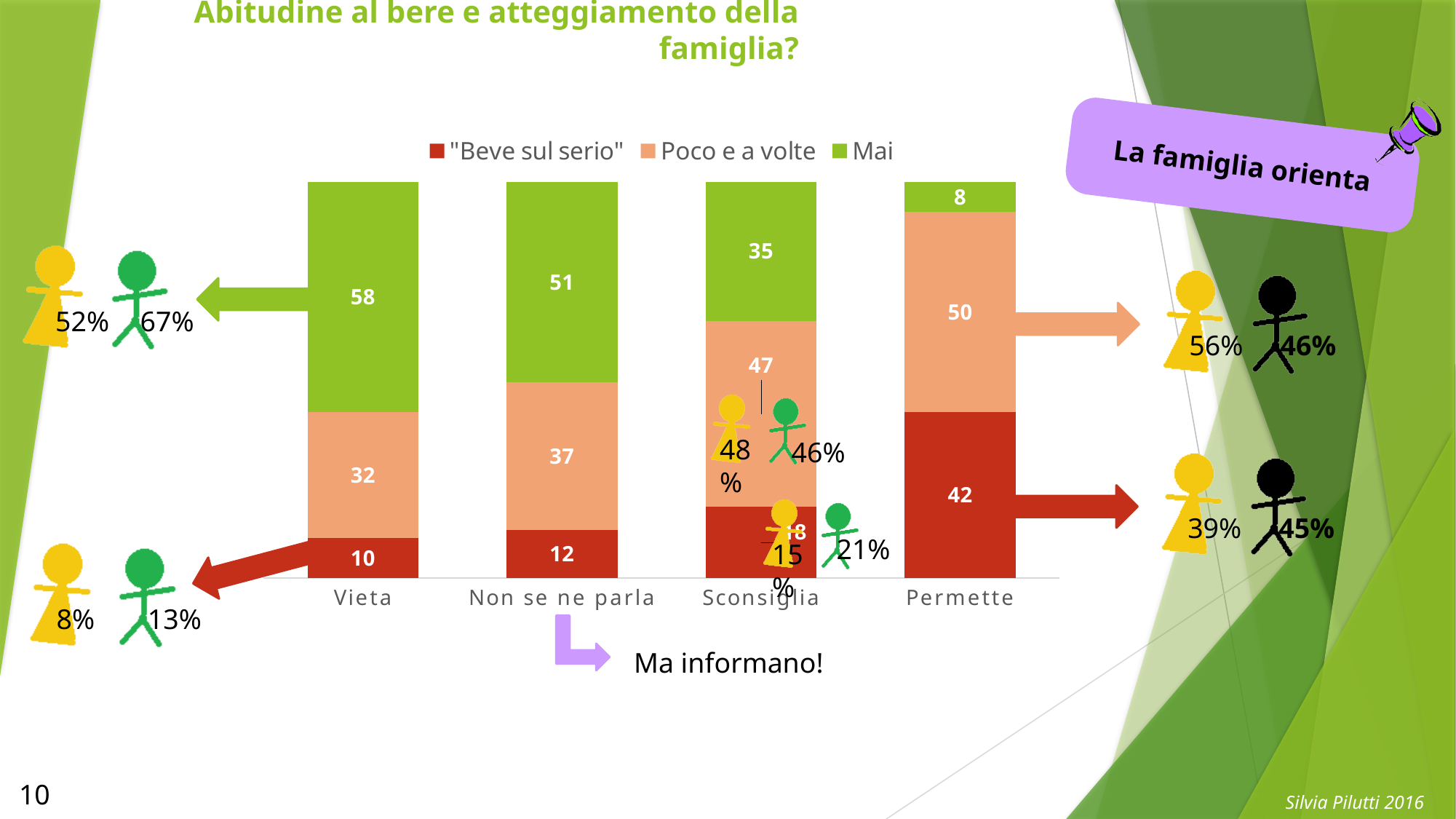
What is the value of "Beve sul serio" for the Permette category? 42 Which category has the highest value for "Beve sul serio"? Permette Which is larger: "Poco e a volte" for Permette or "Poco e a volte" for Sconsiglia? Permette What type of chart is shown on the slide? stacked bar chart What is the total of the stacked bar for Vieta? 100 What is the value of "Poco e a volte" for the Non se ne parla category? 37 How many series does the legend list? 3 What is the value of "Mai" for the Vieta category? 58 What is the difference between the "Mai" values for Vieta and Non se ne parla? 7 How many categories are shown on the x axis? 4 Which category has the lowest value for "Mai"? Permette What is the value of "Mai" for the Sconsiglia category? 35